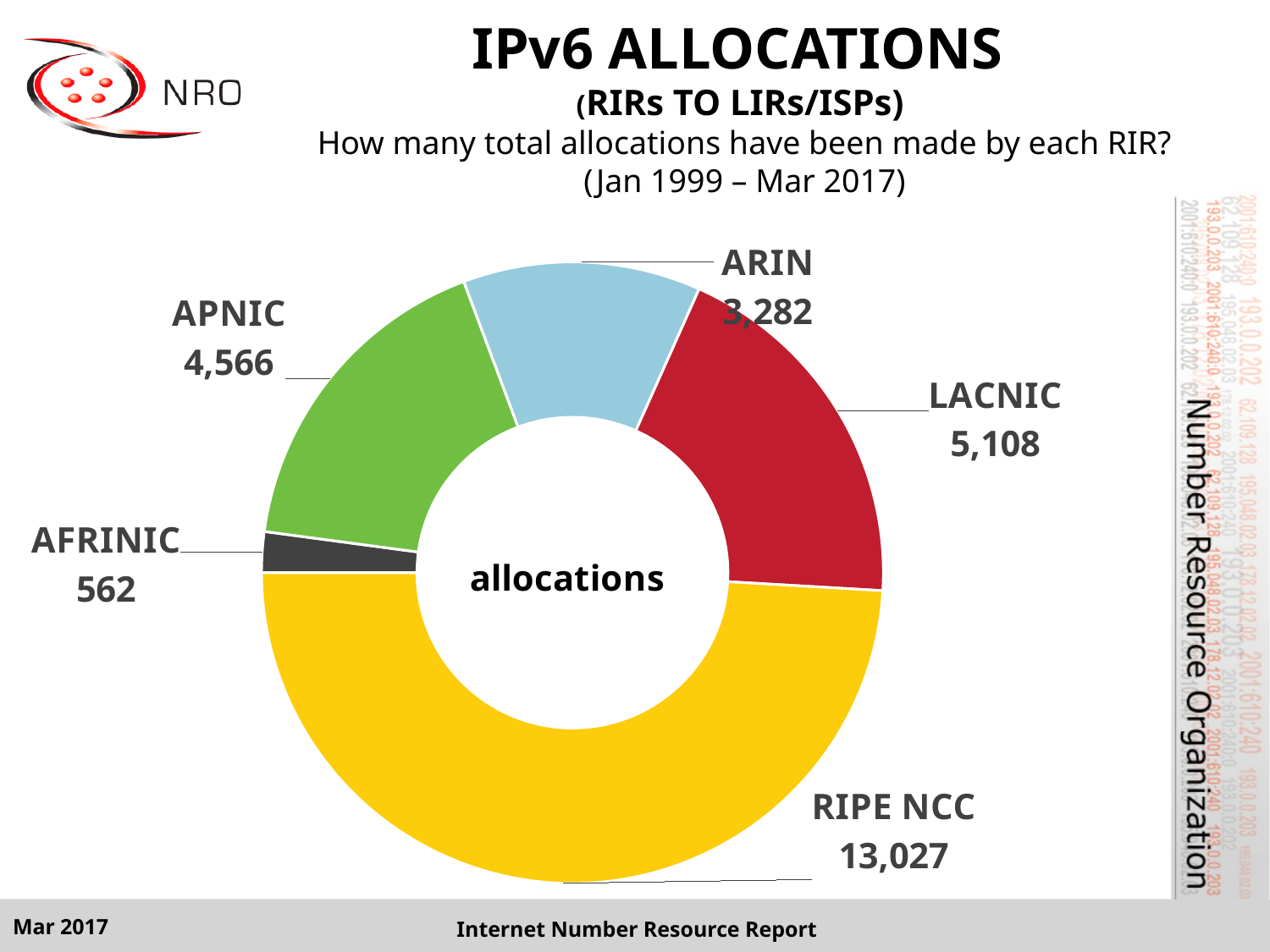
How many allocations are shown for LACNIC? 5,108 How many IPv6 allocations has RIPE NCC made according to the chart? 13,027 How many RIRs are shown in the chart? 5 What is the value shown for AFRINIC? 562 What is the value shown for APNIC? 4,566 What is the total number of IPv6 allocations across all five RIRs shown? 26,545 Which RIR has the lowest number of IPv6 allocations? AFRINIC What kind of chart is used on this slide? Pie chart (donut) Which RIR has the highest number of IPv6 allocations? RIPE NCC Which has more IPv6 allocations, LACNIC or APNIC? LACNIC What is the difference between the allocations of APNIC and ARIN? 1,284 What is the difference between the allocations of RIPE NCC and LACNIC? 7,919